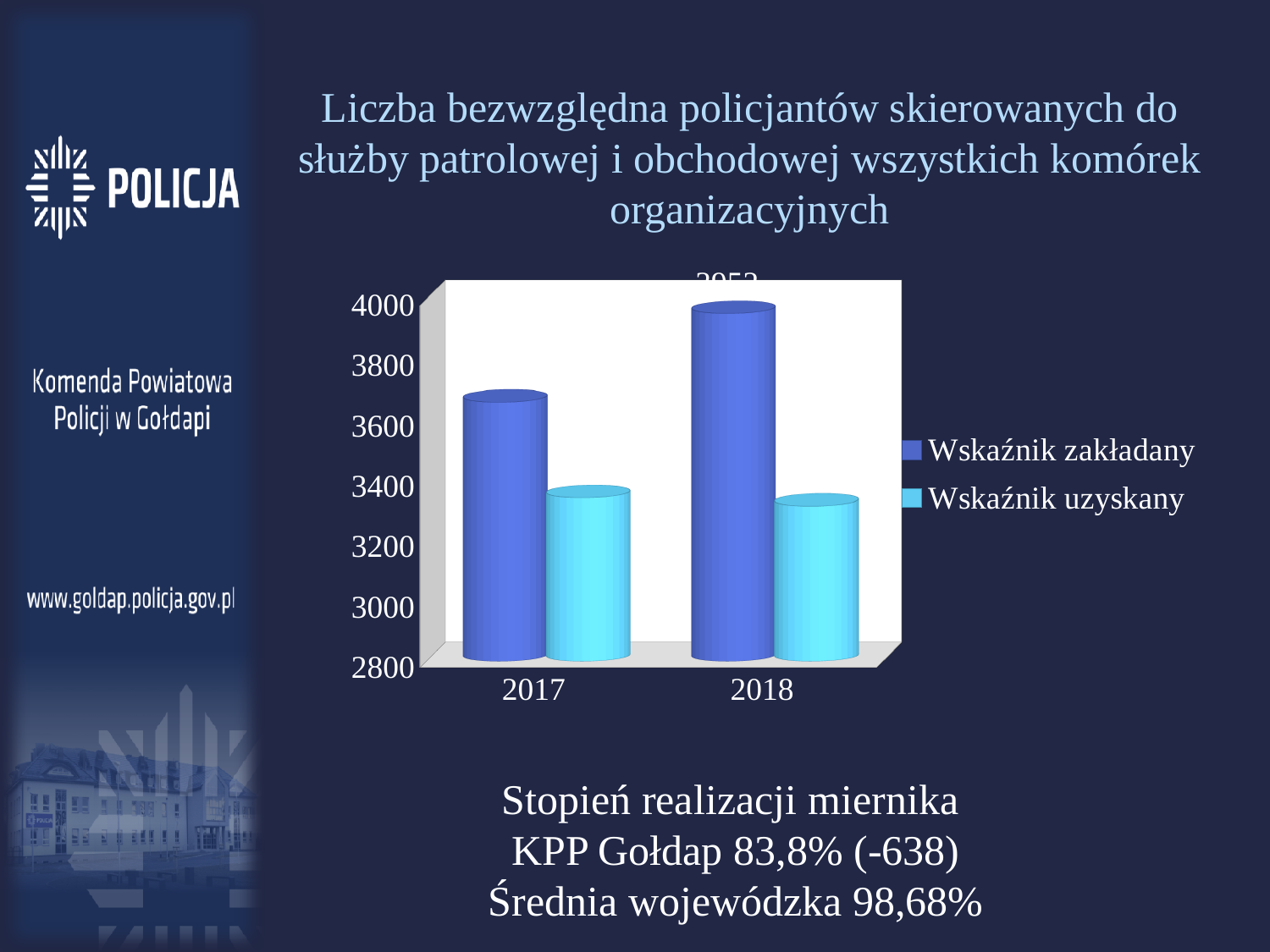
Is the value of Wskaźnik uzyskany for 2017 greater or less than 3400? less Is the value of Wskaźnik zakładany for 2018 greater or less than 3800? greater Does the Wskaźnik zakładany series rise or fall from 2017 to 2018? rise Is the value of Wskaźnik zakładany for 2017 greater or less than 3800? less How many series does the chart legend list? 2 What are the two series named in the chart legend? Wskaźnik zakładany and Wskaźnik uzyskany How many categories (years) are shown on the x axis of the chart? 2 Which years are shown on the x axis of the chart? 2017 and 2018 What kind of chart is shown on the slide? bar chart Which bar is the highest in the chart? Wskaźnik zakładany for 2018